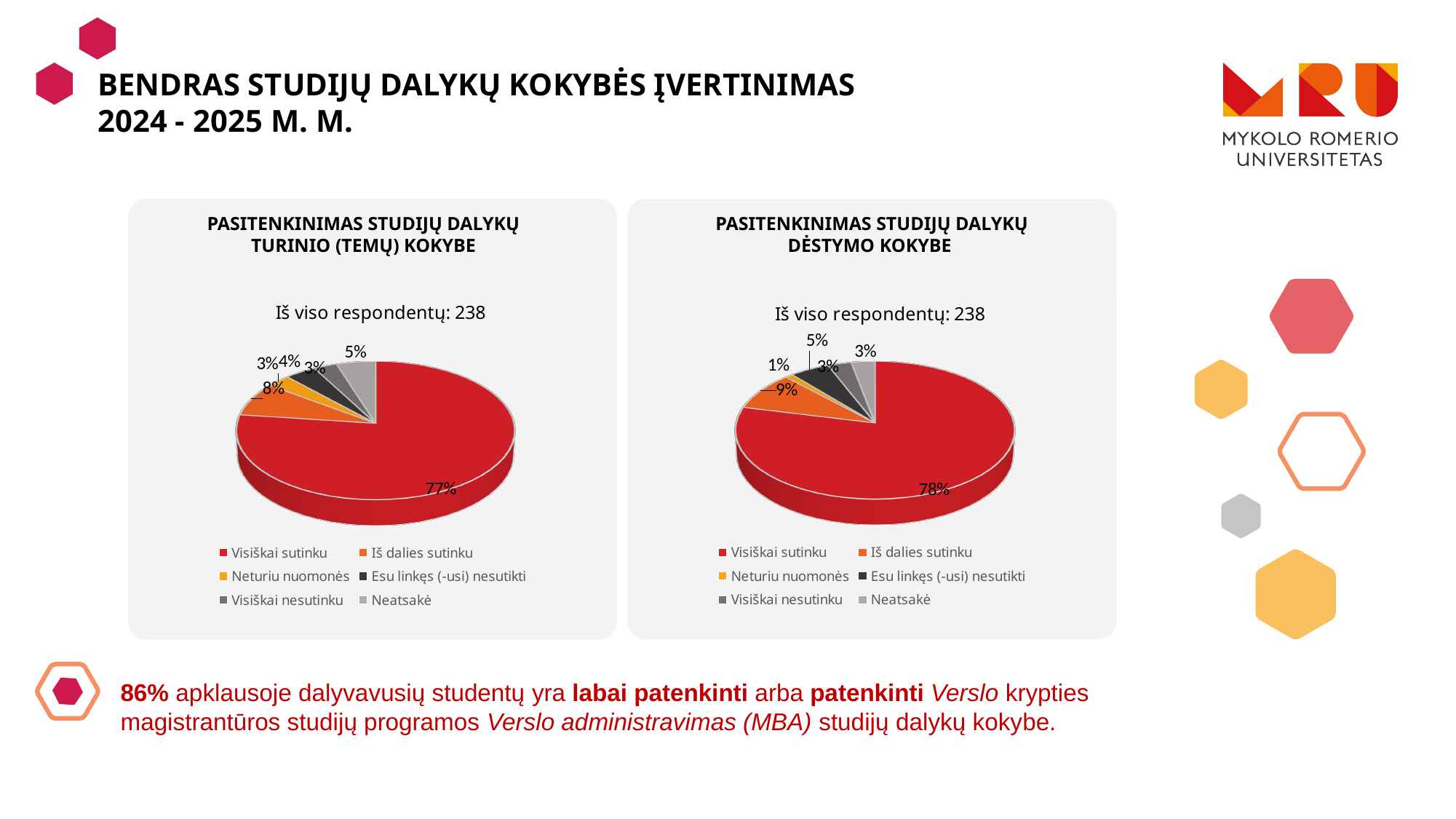
In the left chart (TURINIO (TEMŲ) KOKYBE), which category has the largest slice? Visiškai sutinku In the left chart (TURINIO (TEMŲ) KOKYBE), what share of respondents answered 'Iš dalies sutinku'? 8% How many respondents are reported for the left chart (TURINIO (TEMŲ) KOKYBE)? 238 In the right chart (DĖSTYMO KOKYBE), what share of respondents answered 'Visiškai sutinku'? 78% In the right chart (DĖSTYMO KOKYBE), what share of respondents answered 'Iš dalies sutinku'? 9% In the right chart (DĖSTYMO KOKYBE), which category has the smallest slice? Neturiu nuomonės What kind of chart is used in the 'PASITENKINIMAS STUDIJŲ DALYKŲ TURINIO (TEMŲ) KOKYBE' panel? Pie chart In the left chart (TURINIO (TEMŲ) KOKYBE), what share of respondents answered 'Visiškai sutinku'? 77% In the right chart (DĖSTYMO KOKYBE), what share of respondents is labelled 'Neatsakė'? 3% In the left chart (TURINIO (TEMŲ) KOKYBE), what is the difference between the 'Visiškai sutinku' and 'Iš dalies sutinku' shares? 69 percentage points How many categories does the legend of the right chart (DĖSTYMO KOKYBE) list? 6 Which chart has the larger 'Visiškai sutinku' share, the left (TURINIO (TEMŲ) KOKYBE) or the right (DĖSTYMO KOKYBE)? The right (DĖSTYMO KOKYBE)